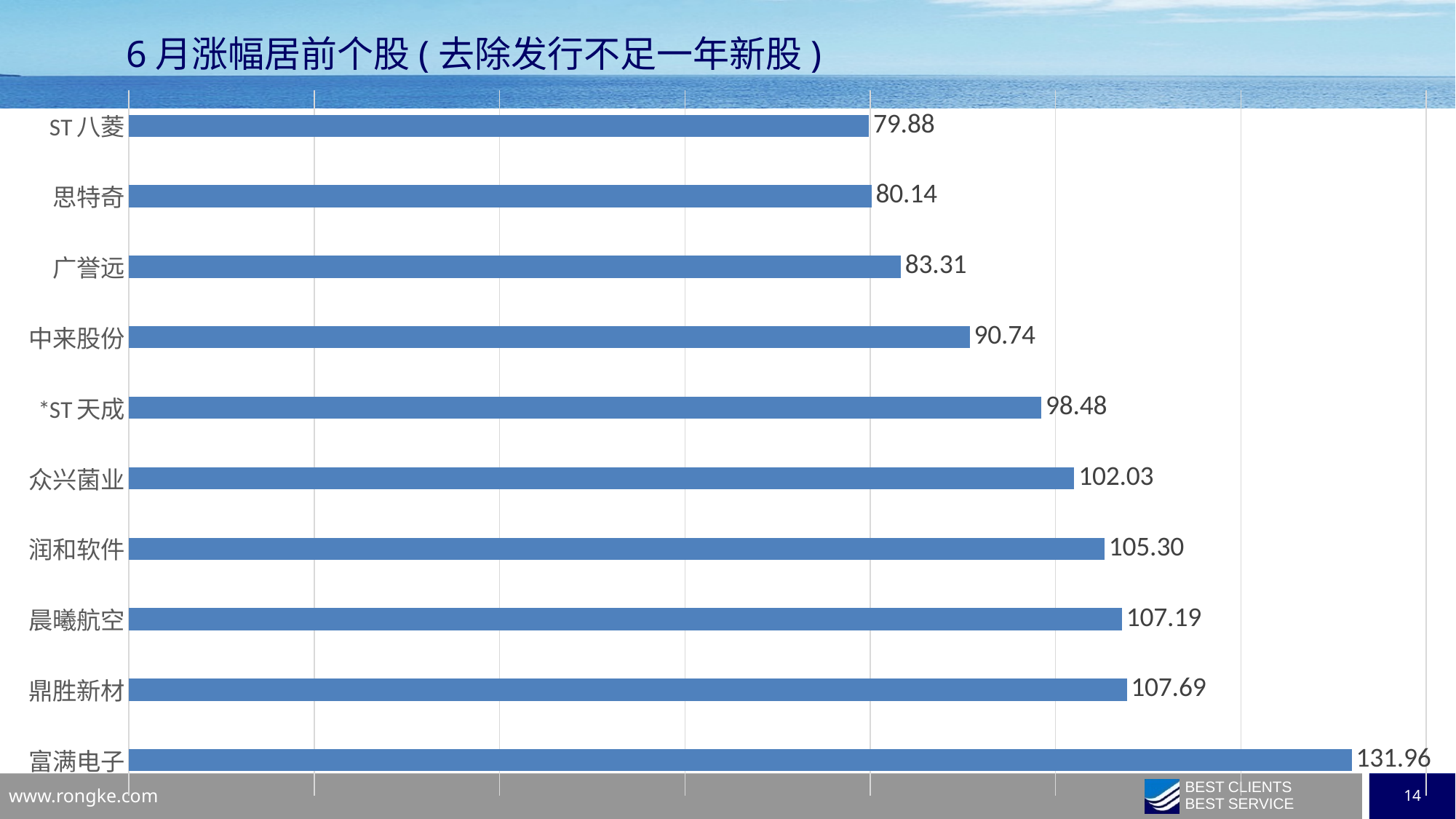
What is the value shown for 富满电子? 131.96 How many stocks are shown on the chart? 10 Which has a larger value, 润和软件 or 众兴菌业? 润和软件 What is the value shown for ST八菱? 79.88 What is the title of the chart? 6月涨幅居前个股(去除发行不足一年新股) What is the difference between the values for 富满电子 and 鼎胜新材? 24.27 Which stock has the highest value on the chart? 富满电子 What is the value shown for *ST天成? 98.48 What kind of chart is shown on the slide? Bar chart Which stock has the lowest value on the chart? ST八菱 What is the value shown for 众兴菌业? 102.03 What is the difference between the values for 中来股份 and 广誉远? 7.43